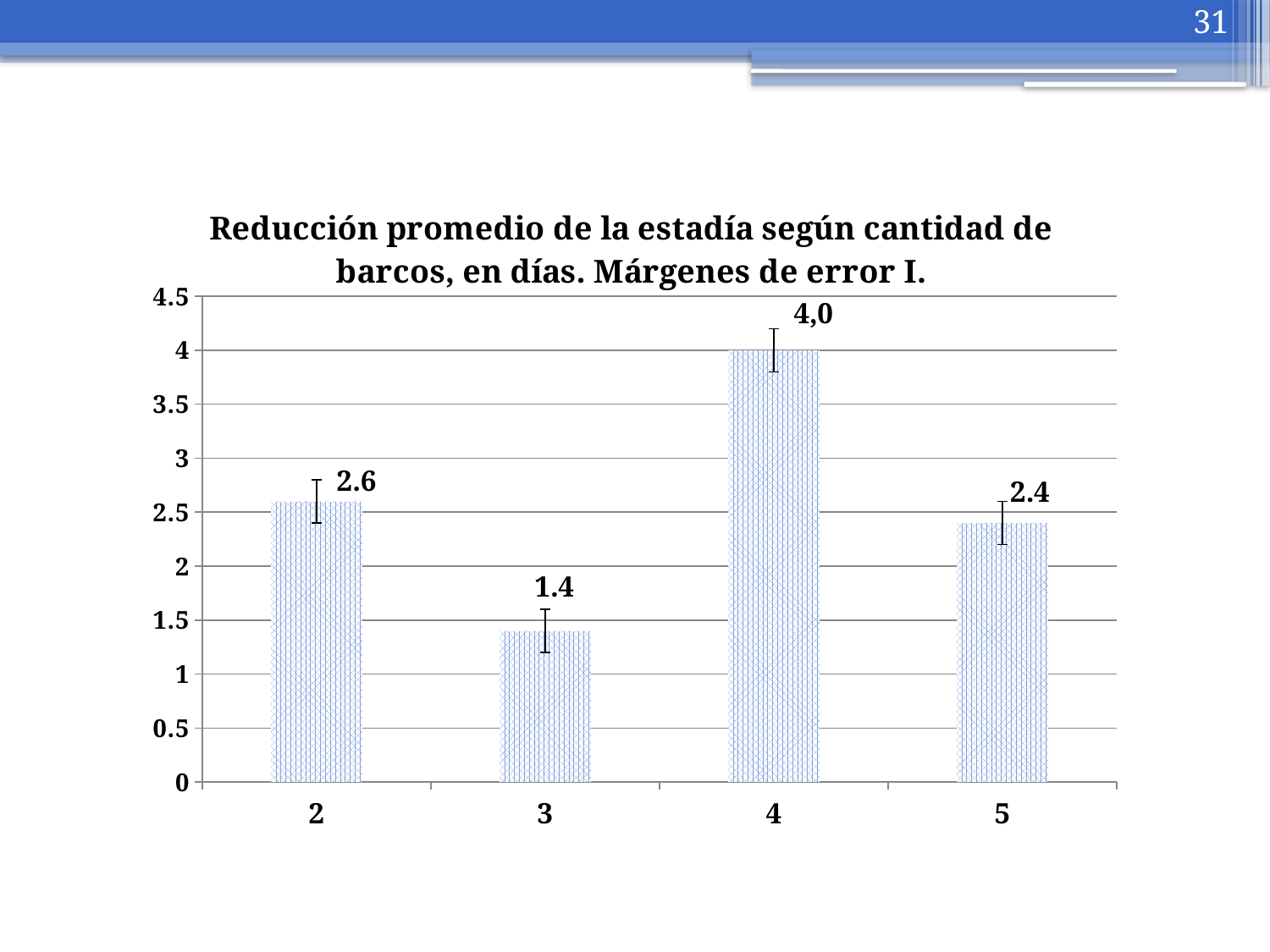
Which is larger, the value for category 2 or the value for category 5? 2 What kind of chart is shown on the slide? bar chart What is the value for category 2? 2.6 What is the value for category 3? 1.4 What is the value for category 4? 4,0 Which category has the lowest value? 3 What is the title of the chart? Reducción promedio de la estadía según cantidad de barcos, en días. Márgenes de error I. What is the value for category 5? 2.4 Is the value for category 3 greater or less than 2? less What is the difference between the values for category 4 and category 3? 2.6 Which category has the highest value? 4 How many categories are shown on the x axis? 4